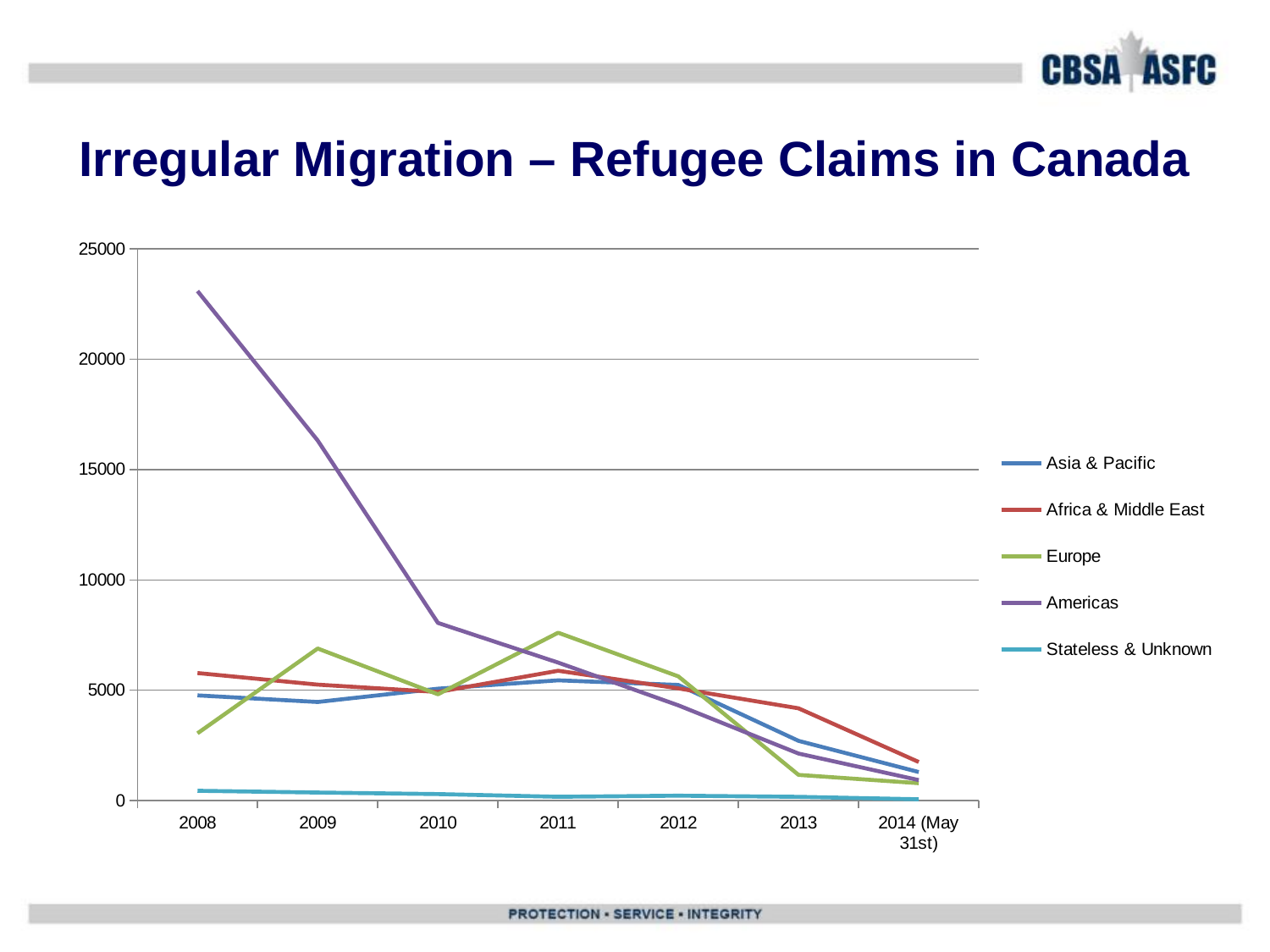
Is the value for Europe in 2009 greater or less than 5000? greater Is the value for Europe in 2013 greater or less than 5000? less Is the value for Americas in 2008 greater or less than 20000? greater Which series has the lowest value in 2008? Stateless & Unknown What kind of chart is shown on the slide? Line chart In 2008, which is larger: Asia & Pacific or Europe? Asia & Pacific What is the title of the slide containing the chart? Irregular Migration – Refugee Claims in Canada How many series does the legend list? 5 How many years (points) are shown along the x axis? 7 Does the Americas series rise or fall from 2008 to 2014 (May 31st)? Fall Which series has the highest value in 2008? Americas